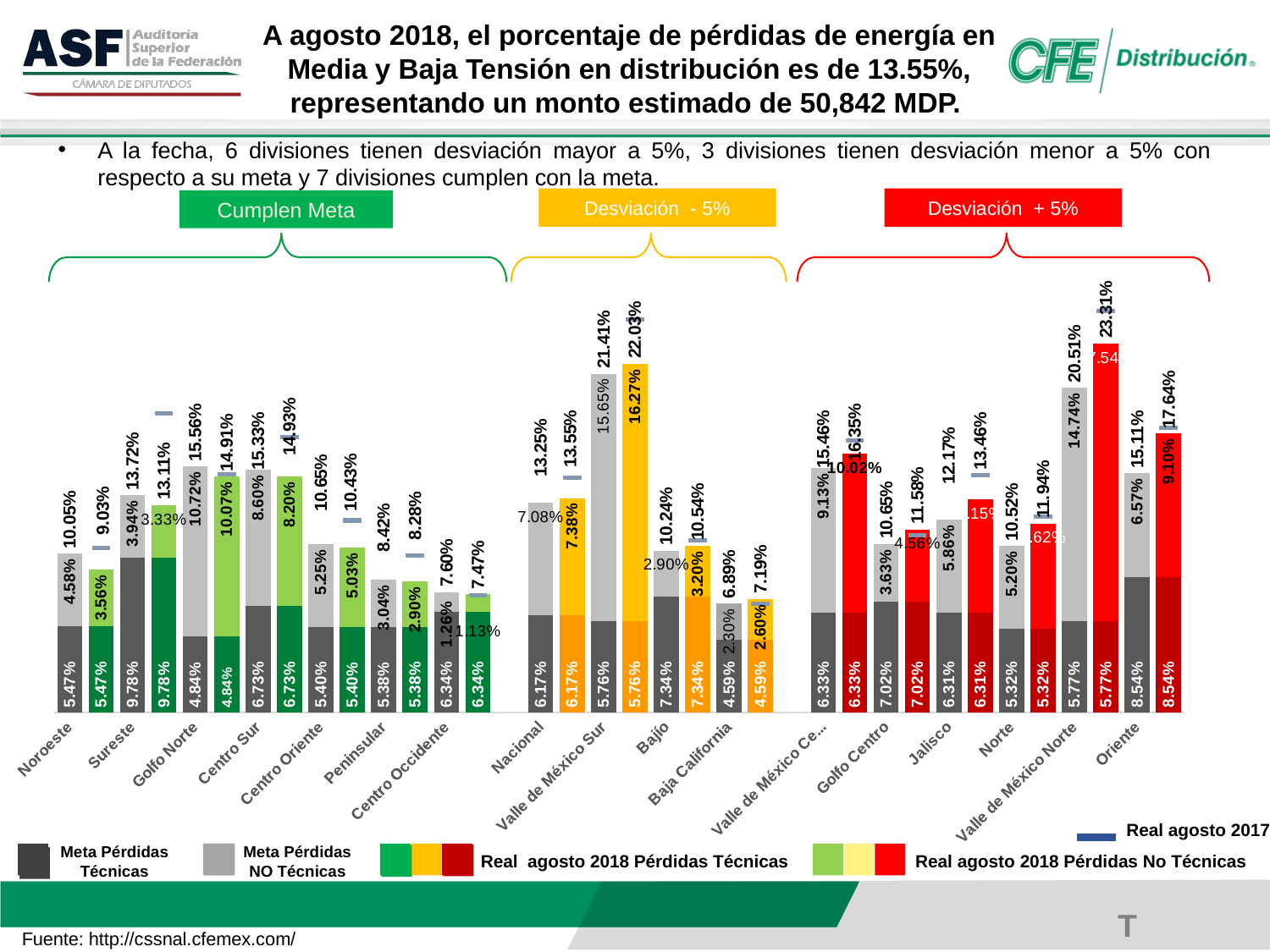
What kind of chart is shown on the slide? Stacked bar chart What is the difference between the Real agosto 2018 total and the Meta total for Nacional? 0.30% What is the Meta Pérdidas Técnicas value for Oriente? 8.54% How many series does the legend list? 5 Which division has the highest Real agosto 2018 total loss percentage? Valle de México Norte What is the total of the Real agosto 2018 stacked bar for Noroeste (5.47% technical plus 3.56% non-technical)? 9.03% How many categories are shown along the x axis of the chart? 17 What is the Real agosto 2018 Pérdidas No Técnicas value for Valle de México Sur? 16.27% Which category has the lowest Real agosto 2018 total loss percentage? Baja California For Golfo Norte, which is larger: the Meta total (15.56%) or the Real agosto 2018 total (14.91%)? Meta total What is the difference between the Real agosto 2018 total (23.31%) and the Meta total (20.51%) for Valle de México Norte? 2.80% What is the total Real agosto 2018 loss percentage labeled for Nacional? 13.55%